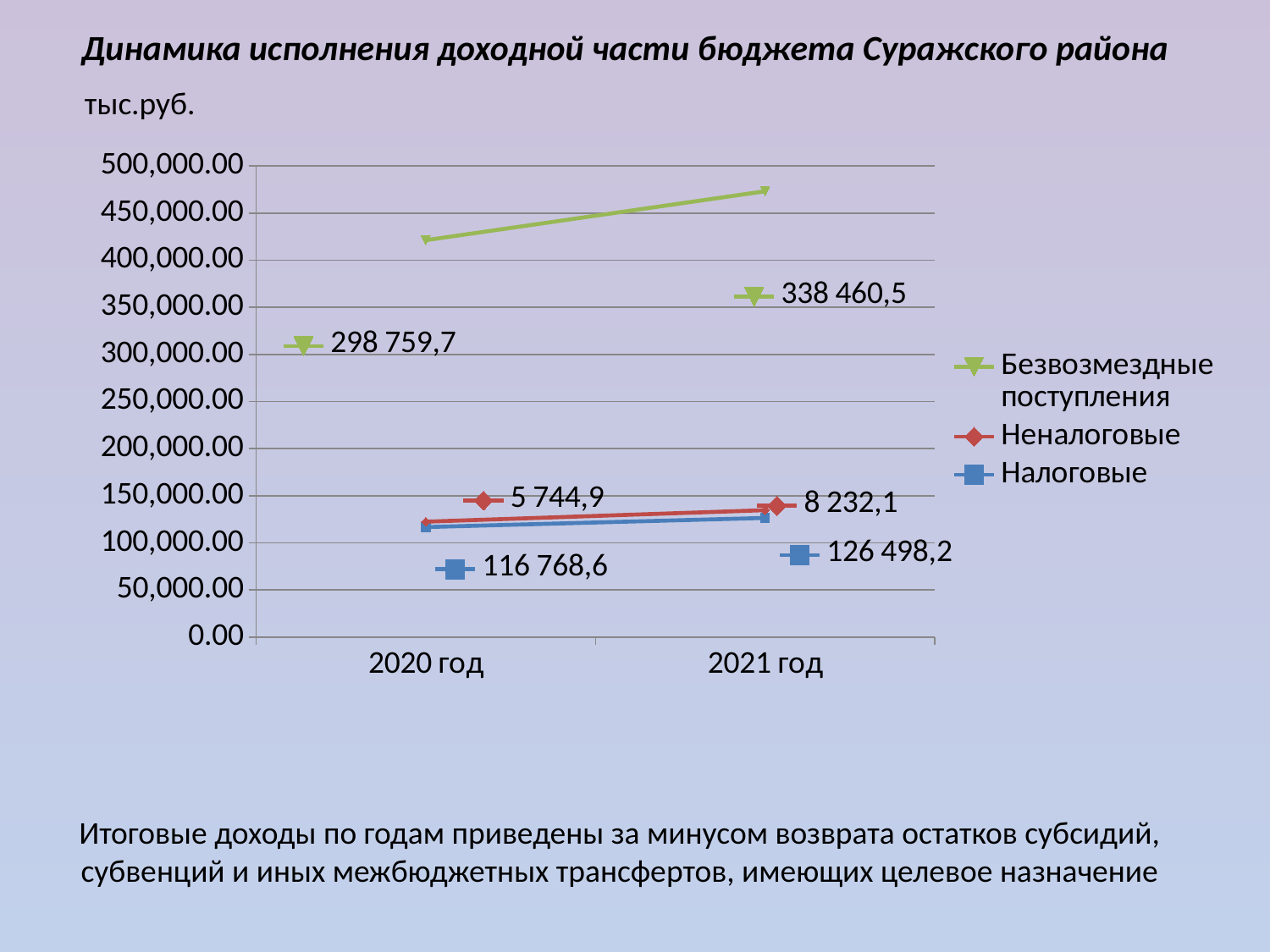
Which series has the highest labelled value in 2020 год? Безвозмездные поступления Does the labelled value for Неналоговые rise or fall from 2020 год to 2021 год? rise How many years are shown on the x axis? 2 What is the labelled value for Неналоговые in 2021 год? 8 232,1 What is the labelled value for Налоговые in 2020 год? 116 768,6 What is the labelled value for Безвозмездные поступления in 2020 год? 298 759,7 Which series has the lowest labelled value in 2021 год? Неналоговые What is the labelled value for Безвозмездные поступления in 2021 год? 338 460,5 What type of chart is shown on the slide? line chart What unit of measurement is stated above the chart? тыс.руб. How many series does the legend list? 3 By how much did the labelled value for Налоговые change from 2020 год to 2021 год? 9 729,6